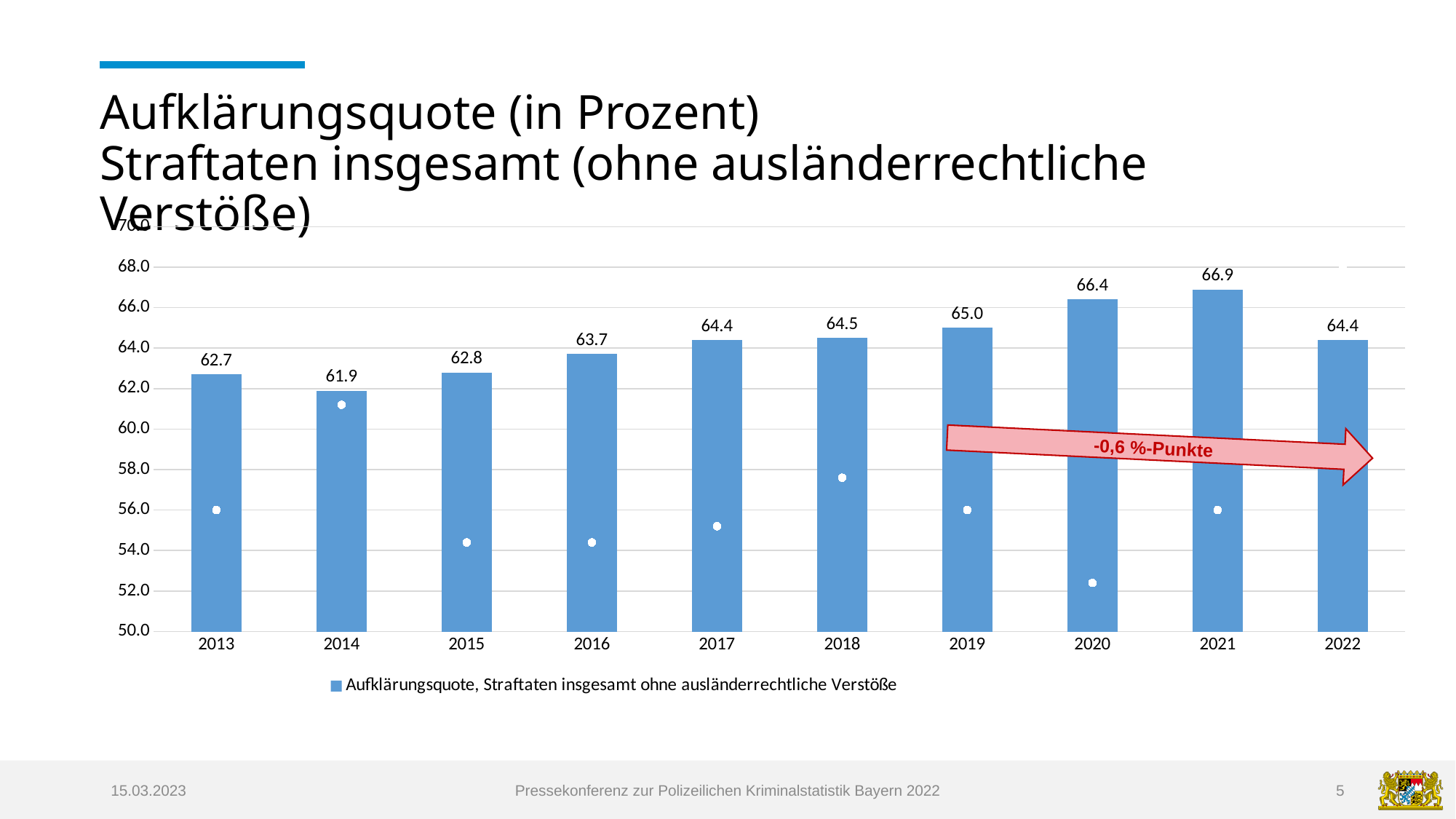
Is the value for 2018 greater or less than 64.0? greater Which year has the higher Aufklärungsquote, 2016 or 2020? 2020 How many series does the legend list? 1 Which year has the lowest Aufklärungsquote? 2014 What is the Aufklärungsquote for 2019? 65.0 What change does the red arrow annotation on the chart indicate? -0,6 %-Punkte What is the Aufklärungsquote for 2014? 61.9 What is the Aufklärungsquote for 2022? 64.4 How many years are shown on the x axis of the chart? 10 What kind of chart is shown on the slide? bar chart Which year has the highest Aufklärungsquote? 2021 What is the difference between the Aufklärungsquote in 2021 and in 2022? 2.5